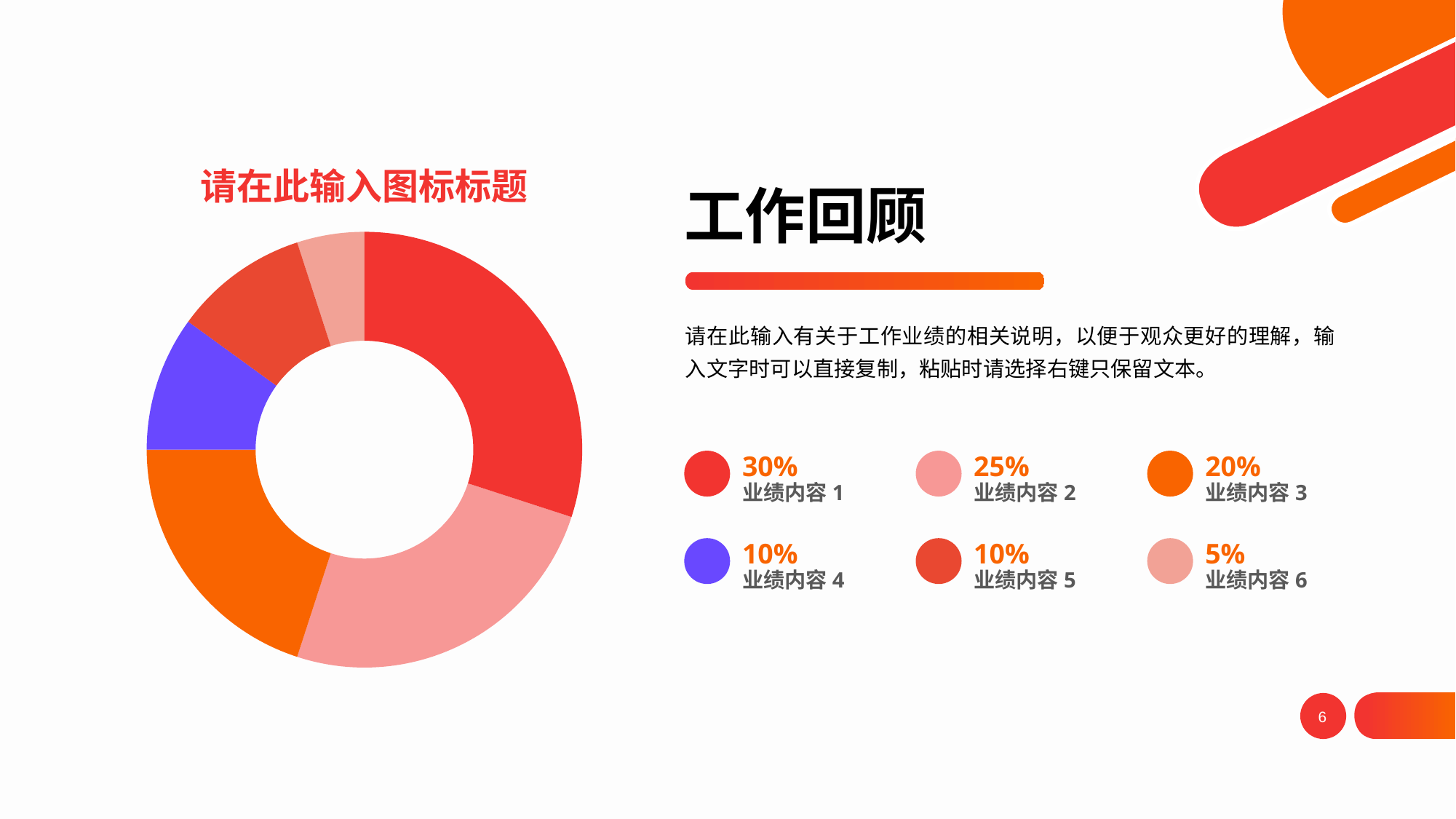
What is the difference between the shares of 业绩内容 3 and 业绩内容 6? 15% What kind of chart is shown on the slide? Donut (pie) chart What is the value shown for 业绩内容 6? 5% What share of the donut chart does 业绩内容 1 represent? 30% Which category has the largest share of the donut chart? 业绩内容 1 Which is larger, the share of 业绩内容 2 or the share of 业绩内容 4? 业绩内容 2 How many categories are shown in the donut chart? 6 What is the difference between the shares of 业绩内容 1 and 业绩内容 2? 5% Which category has the smallest share of the donut chart? 业绩内容 6 What is the title of the chart? 请在此输入图标标题 What is the value shown for 业绩内容 3? 20% What colour is the slice for 业绩内容 4? Purple